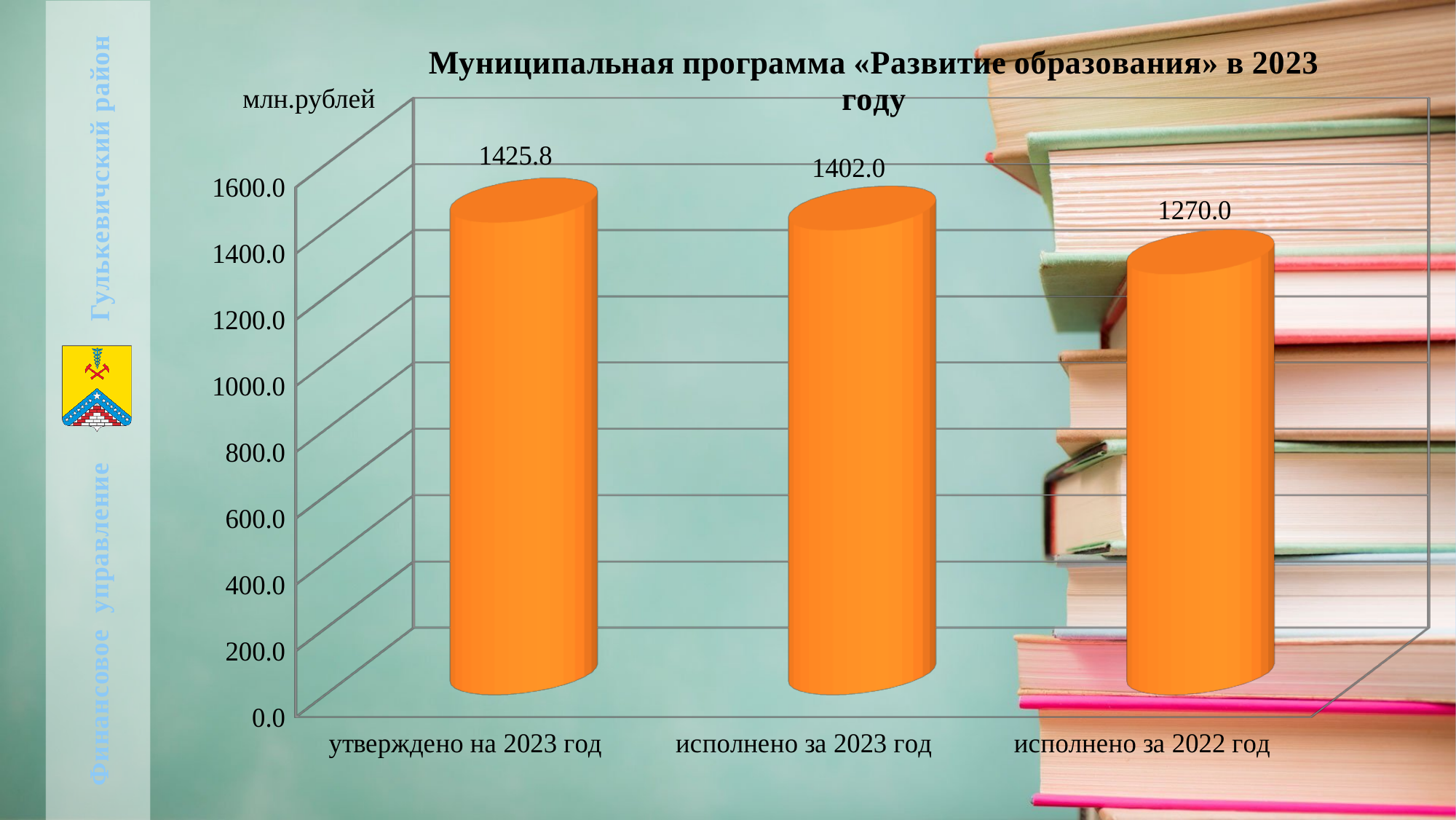
What is the title of the chart? Муниципальная программа «Развитие образования» в 2023 году What is the value for «утверждено на 2023 год»? 1425.8 What kind of chart is shown on the slide? bar chart Is the value for «исполнено за 2022 год» greater or less than 1400.0? less Which category has the highest value? утверждено на 2023 год What is the value for «исполнено за 2022 год»? 1270.0 How many categories are shown on the chart? 3 Which is larger: «исполнено за 2023 год» or «исполнено за 2022 год»? исполнено за 2023 год What is the difference between «утверждено на 2023 год» and «исполнено за 2023 год»? 23.8 Which category has the lowest value? исполнено за 2022 год What is the difference between «исполнено за 2023 год» and «исполнено за 2022 год»? 132.0 What is the value for «исполнено за 2023 год»? 1402.0